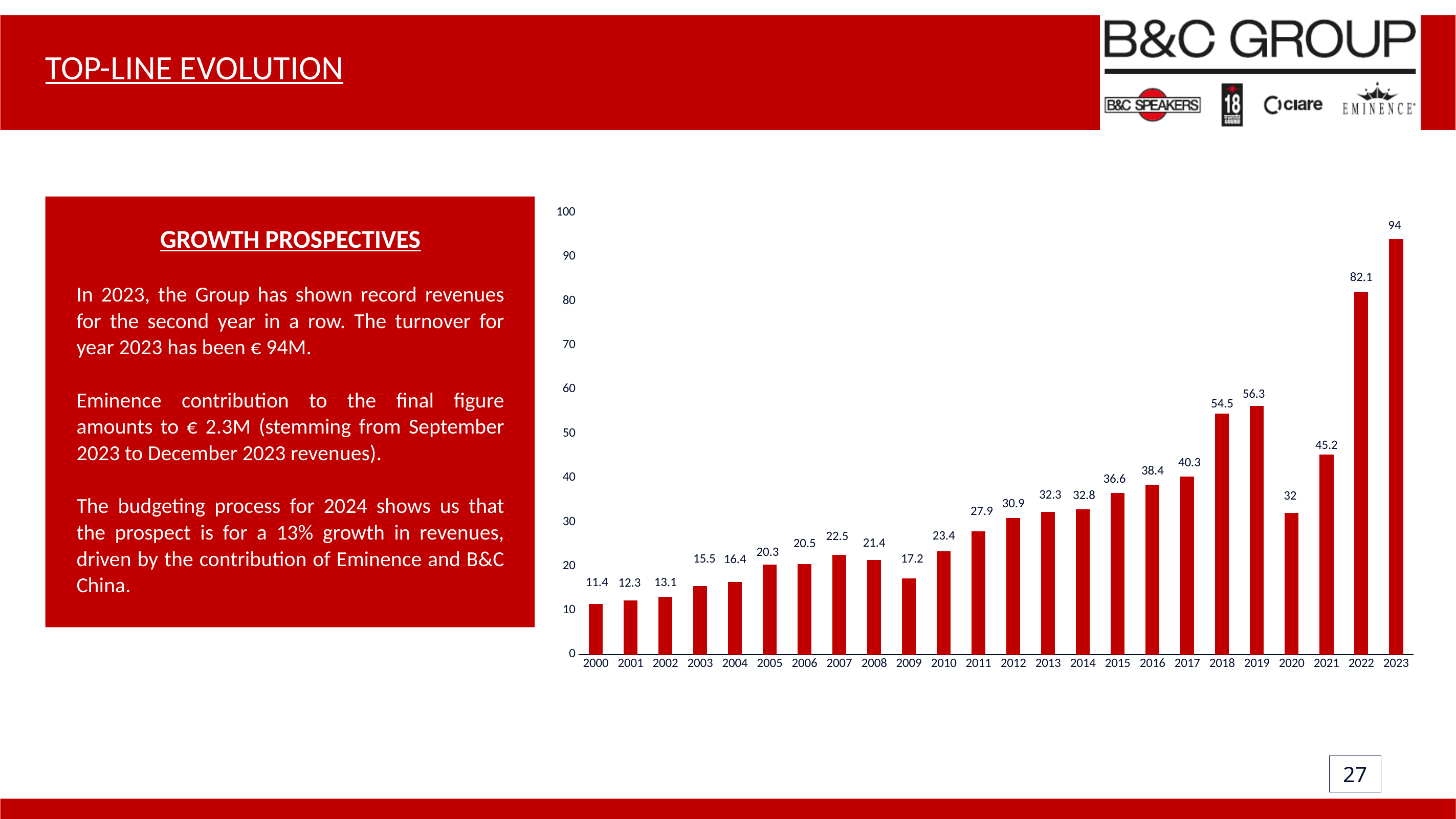
Which year has the lowest value? 2000 What is the difference between the values for 2023 and 2022? 11.9 Is the value for 2022 greater or less than 80? greater What is the value shown for 2023? 94 What is the value shown for 2020? 32 What is the value shown for 2009? 17.2 Do the values generally rise or fall from 2000 to 2023? rise What kind of chart is shown on the slide? bar chart How many years are shown on the x axis? 24 Which is larger, the value for 2021 or the value for 2020? 2021 What is the difference between the values for 2019 and 2018? 1.8 Which year has the highest value? 2023